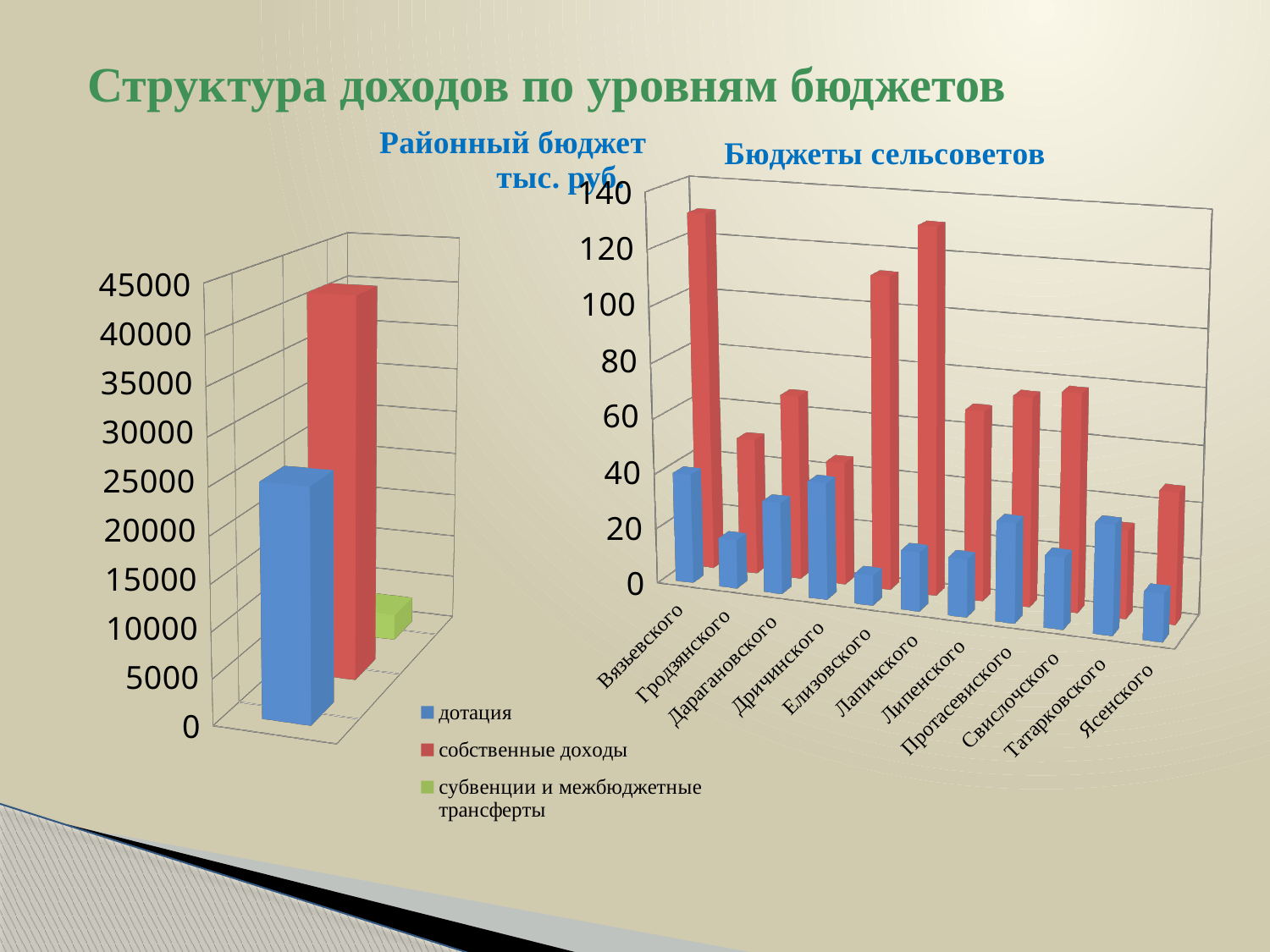
What kind of chart is the "Бюджеты сельсоветов" chart? bar chart In the "Бюджеты сельсоветов" chart, which category has the lowest value for собственные доходы? Татарковского In the "Бюджеты сельсоветов" chart, which is larger for собственные доходы: Дарагановского or Гродзянского? Дарагановского In the "Районный бюджет тыс. руб" chart, which series has the lowest value? субвенции и межбюджетные трансферты In the "Бюджеты сельсоветов" chart, is the value of собственные доходы for Татарковского greater or less than 40? less In the "Районный бюджет тыс. руб" chart, is the value for дотация greater or less than 20000? greater In the "Бюджеты сельсоветов" chart, is the value of собственные доходы for Вязьевского greater or less than 120? greater How many categories are shown on the x axis of the "Бюджеты сельсоветов" chart? 11 What colour represents дотация in the charts? blue How many series does the legend on the slide list? 3 In the "Районный бюджет тыс. руб" chart, which series has the highest value? собственные доходы